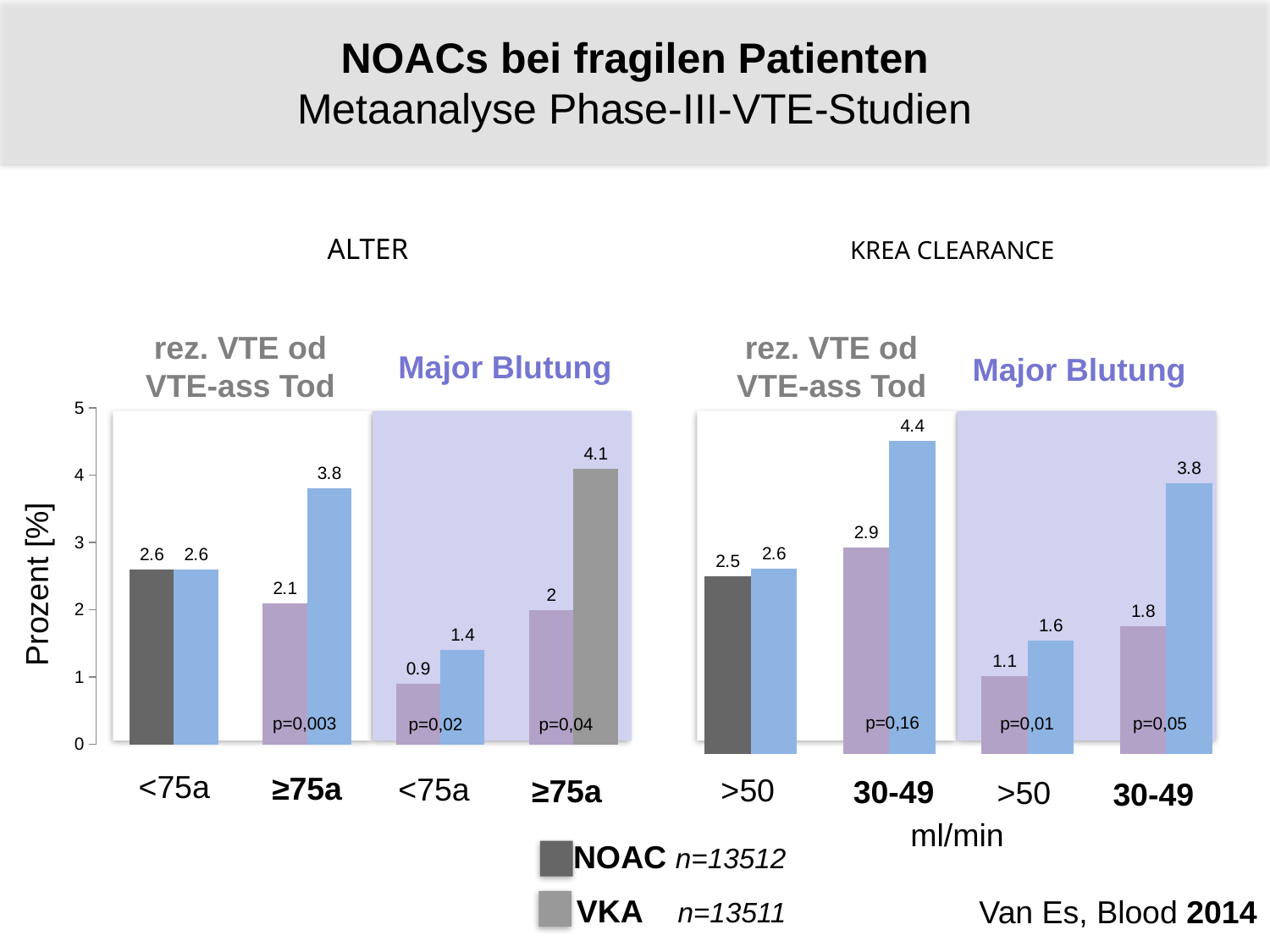
In the ALTER chart, which is larger for rez. VTE od VTE-ass Tod in patients ≥75a: NOAC or VKA? VKA In the KREA CLEARANCE chart, what is the difference between the VKA and NOAC values for Major Blutung at 30-49 ml/min? 2 What type of chart is used on this slide? bar chart What is the p-value shown for rez. VTE od VTE-ass Tod in patients ≥75a in the ALTER chart? p=0,003 In the ALTER chart, which bar is the lowest overall? NOAC, Major Blutung, <75a How many series does the legend list? 2 In the KREA CLEARANCE chart, what is the NOAC value for Major Blutung at >50 ml/min? 1.1 In the ALTER chart, what is the VKA value for Major Blutung in patients ≥75a? 4.1 In the ALTER chart, what is the difference between the VKA and NOAC values for Major Blutung in patients ≥75a? 2.1 In the KREA CLEARANCE chart, what is the VKA value for rez. VTE od VTE-ass Tod at 30-49 ml/min? 4.4 In the KREA CLEARANCE chart, which bar is the highest overall? VKA, rez. VTE od VTE-ass Tod, 30-49 In the ALTER chart, what is the NOAC value for rez. VTE od VTE-ass Tod in patients ≥75a? 2.1